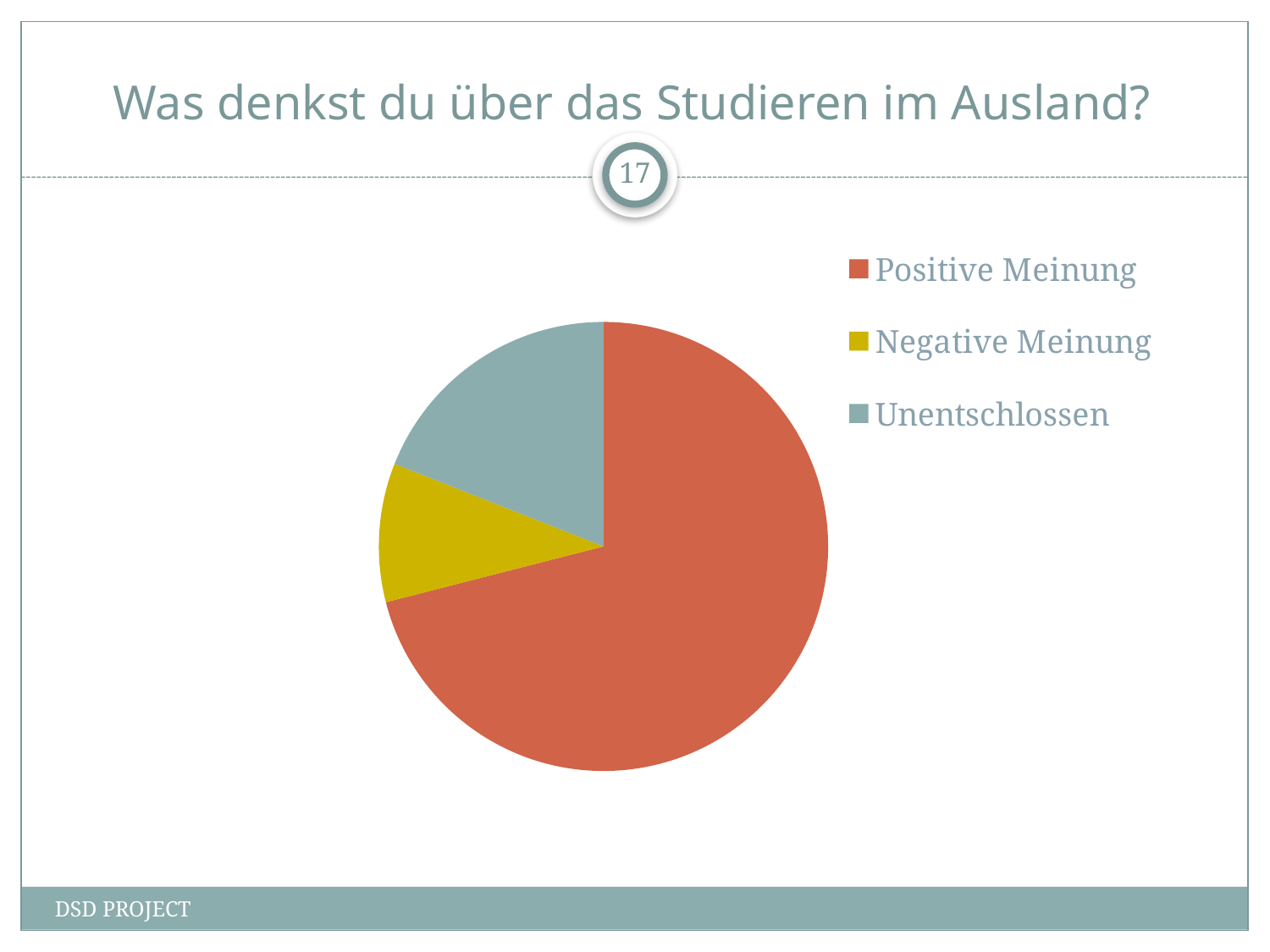
How many slices does the pie chart have? 3 Which slice is larger, Unentschlossen or Negative Meinung? Unentschlossen Which colour represents Negative Meinung in the pie chart? yellow What kind of chart is shown on the slide? pie chart Which slice is larger, Positive Meinung or Unentschlossen? Positive Meinung Which category has the smallest slice of the pie chart? Negative Meinung How many entries does the legend of the pie chart list? 3 Which category has the largest slice of the pie chart? Positive Meinung What is the title of the slide containing the pie chart? Was denkst du über das Studieren im Ausland?